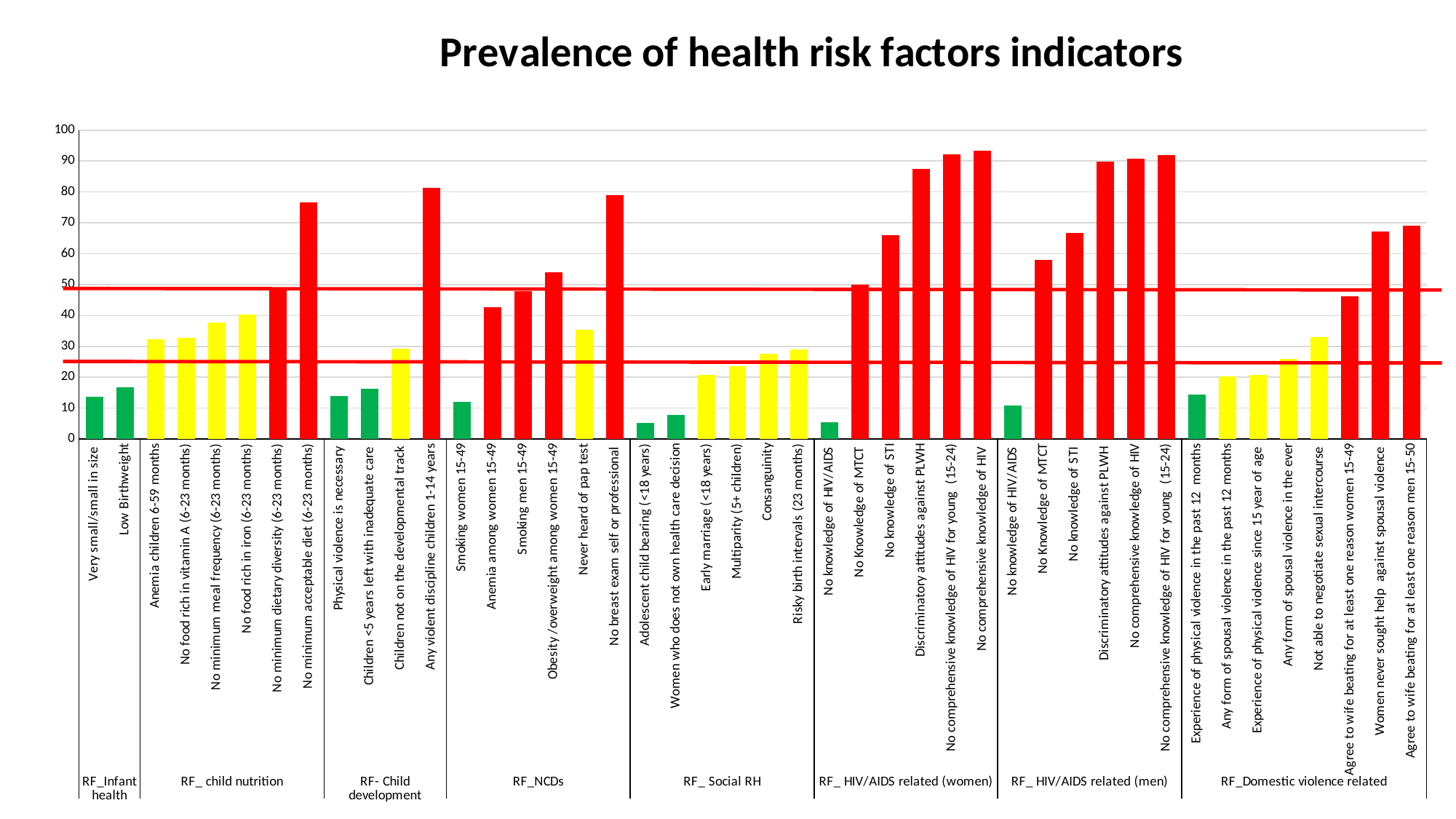
Is the value for 'Obesity/overweight among women 15-49' greater or less than 50? greater Is the value for 'Women never sought help against spousal violence' greater or less than 60? greater How many indicator groups (such as RF_Infant health, RF_NCDs) are labelled along the bottom of the chart? 8 Which is larger: 'No Knowledge of MTCT' in the RF_HIV/AIDS related (women) group or 'No Knowledge of MTCT' in the RF_HIV/AIDS related (men) group? RF_HIV/AIDS related (men) Is the value for 'Low Birthweight' greater or less than 20? less What is the title of the chart? Prevalence of health risk factors indicators What kind of chart is shown on the slide? bar chart Which is larger: 'Anemia children 6-59 months' or 'No food rich in iron (6-23 months)'? No food rich in iron (6-23 months) How many bars are plotted in the RF_Domestic violence related group? 8 How many different bar colours are used in the chart? 3